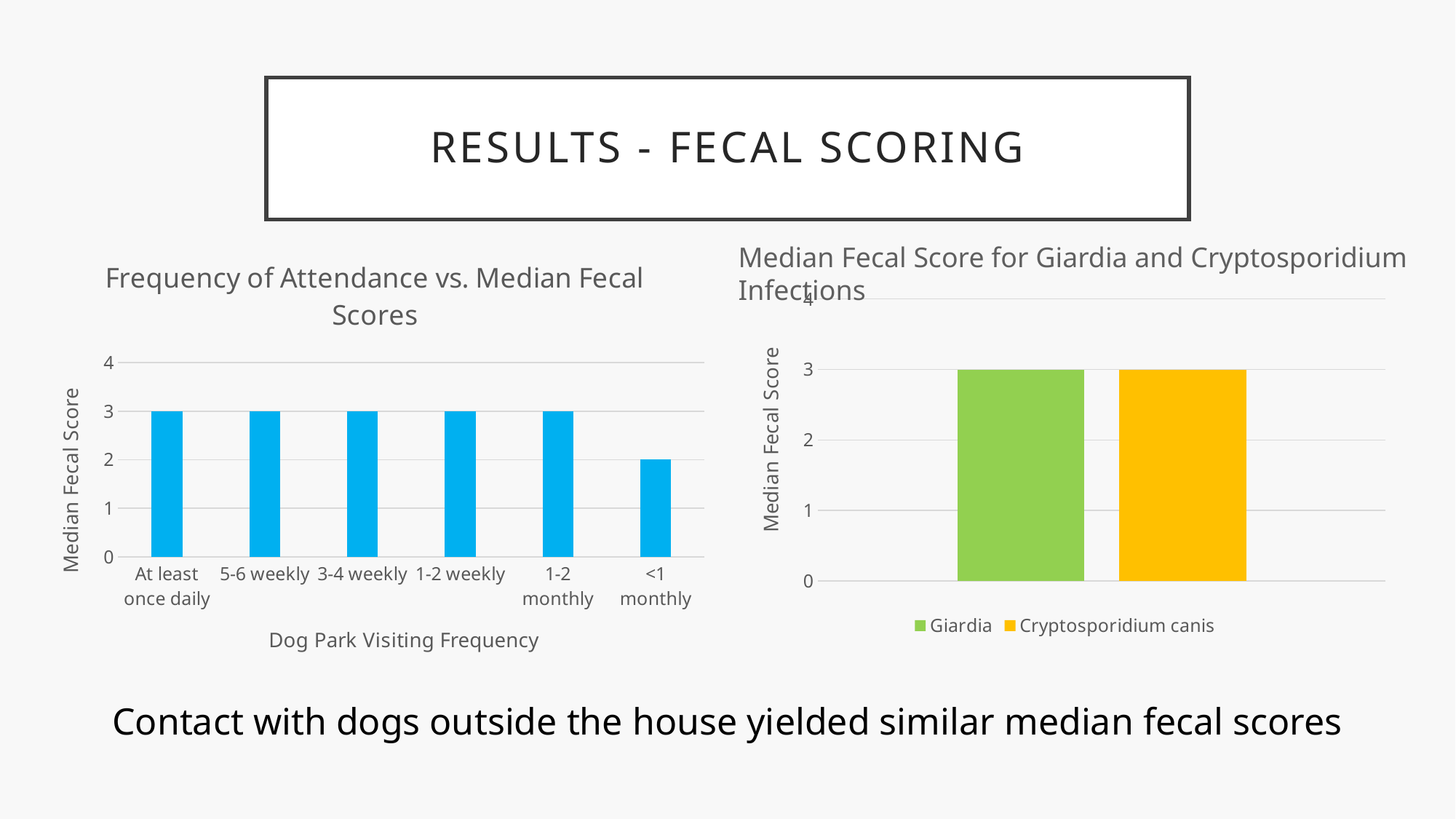
In the 'Frequency of Attendance vs. Median Fecal Scores' chart, which is larger: the median fecal score for '5-6 weekly' or for '<1 monthly'? 5-6 weekly In the 'Frequency of Attendance vs. Median Fecal Scores' chart, what is the x-axis title? Dog Park Visiting Frequency In the 'Frequency of Attendance vs. Median Fecal Scores' chart, which visiting frequency has the lowest median fecal score? <1 monthly In the 'Frequency of Attendance vs. Median Fecal Scores' chart, what is the difference between the median fecal score for '1-2 weekly' and for '<1 monthly'? 1 In the 'Frequency of Attendance vs. Median Fecal Scores' chart, what is the median fecal score for '<1 monthly'? 2 In the 'Median Fecal Score for Giardia and Cryptosporidium Infections' chart, what is the median fecal score for Cryptosporidium canis? 3 In the 'Frequency of Attendance vs. Median Fecal Scores' chart, what is the median fecal score for 'At least once daily'? 3 In the 'Frequency of Attendance vs. Median Fecal Scores' chart, how many visiting frequency categories are shown? 6 What type of chart is the 'Frequency of Attendance vs. Median Fecal Scores' chart? Bar chart In the 'Median Fecal Score for Giardia and Cryptosporidium Infections' chart, what is the median fecal score for Giardia? 3 In the 'Median Fecal Score for Giardia and Cryptosporidium Infections' chart, how many series does the legend list? 2 In the 'Median Fecal Score for Giardia and Cryptosporidium Infections' chart, what colour is the Giardia bar? Green